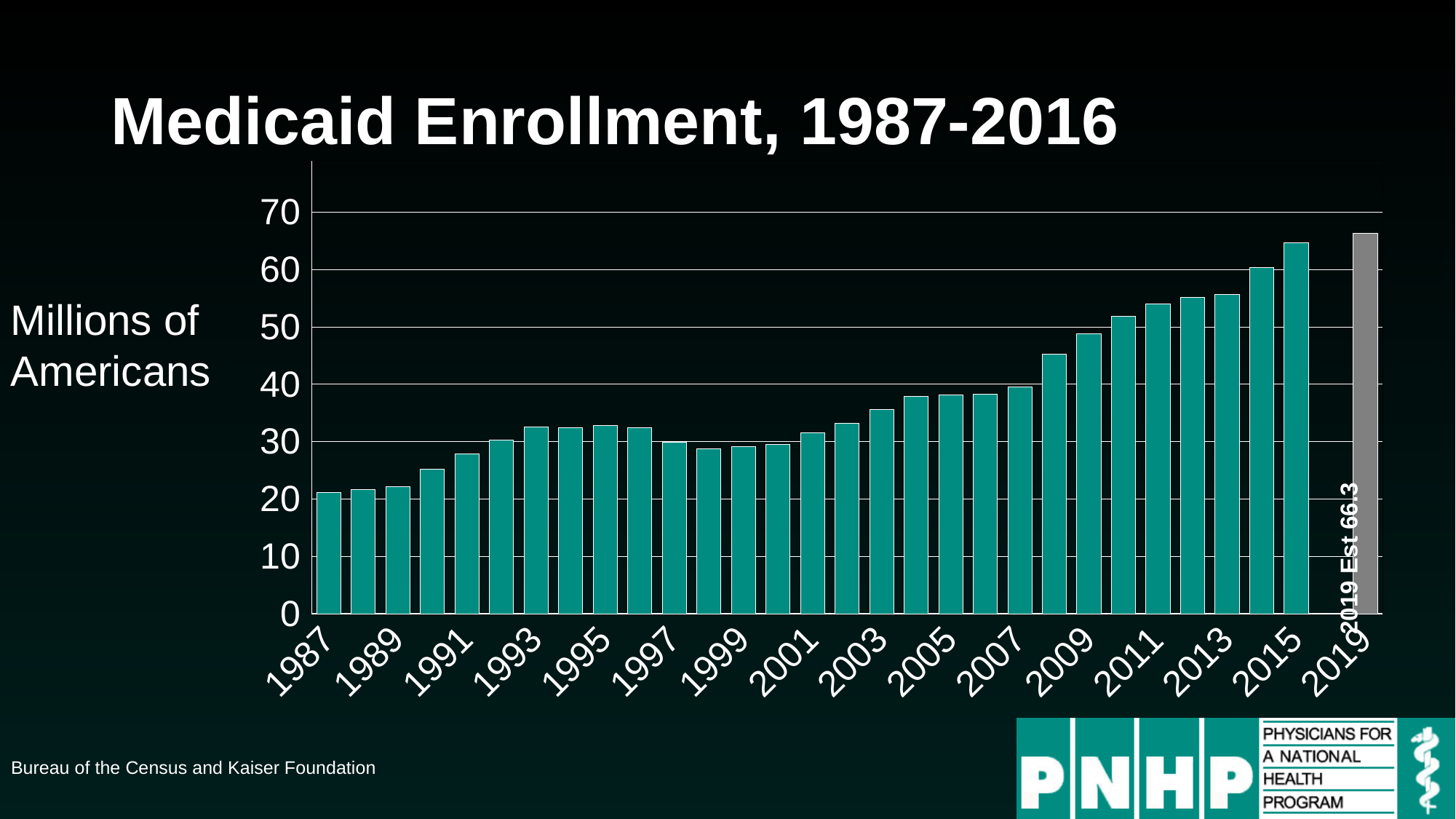
What is the title of the chart? Medicaid Enrollment, 1987-2016 Is the value for 2009 greater or less than 40? greater Is the value for 2015 greater or less than 60? greater What type of chart is shown on the slide? bar chart What is the estimated Medicaid enrollment value printed for 2019? 66.3 Is the value for 2013 greater or less than 50? greater Which is larger, the value for 2015 or the value for 1995? 2015 Which year has the tallest bar in the chart? 2019 Which year has the shortest bar in the chart? 1987 What unit does the label to the left of the chart say the values are in? Millions of Americans Overall, do the values rise or fall from 1987 to 2019? rise